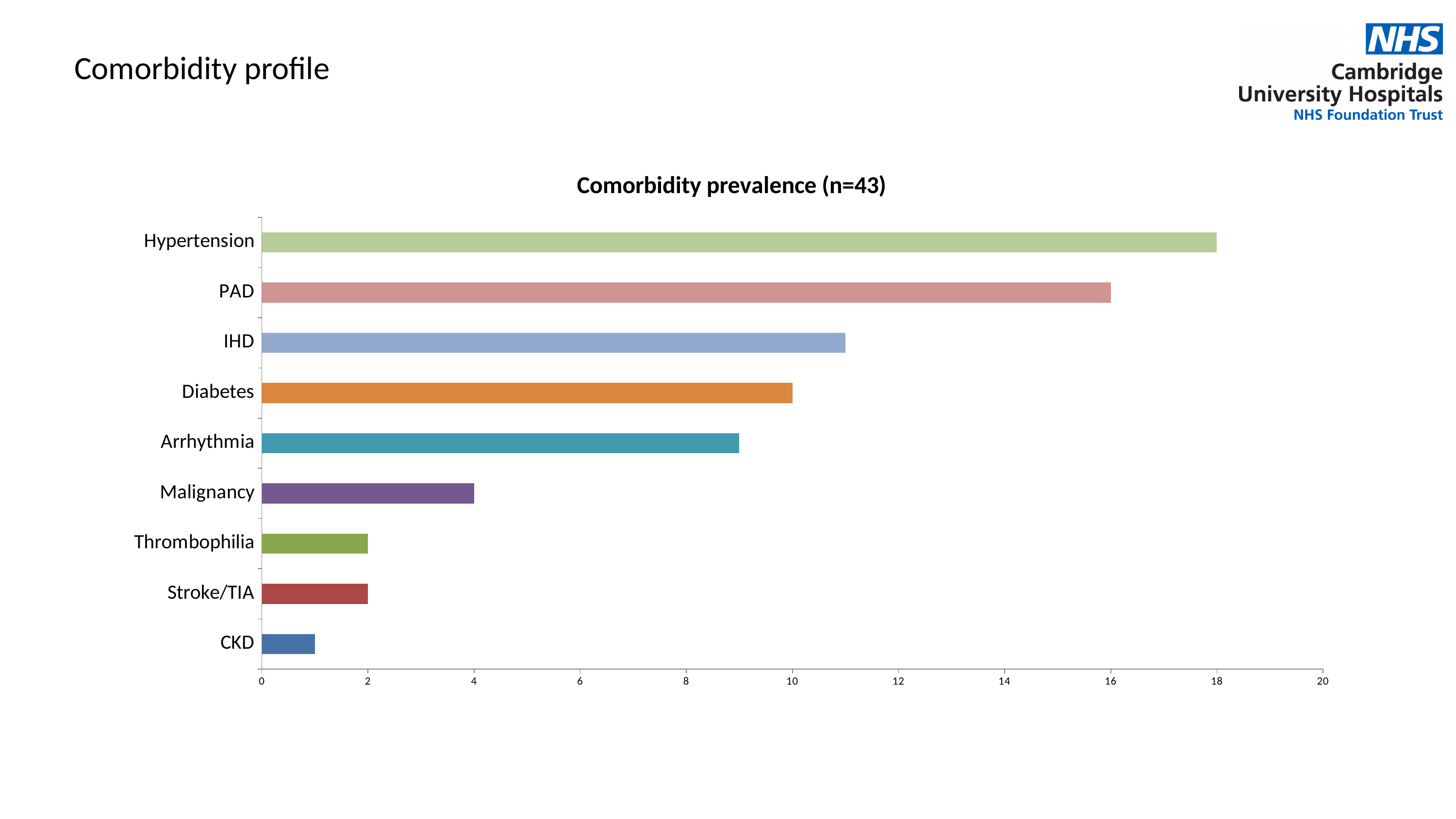
What is the difference between the values for Hypertension and PAD? 2 What is the title of the chart? Comorbidity prevalence (n=43) What is the value for Hypertension? 18 What is the value for Diabetes? 10 What type of chart is shown on the slide? bar chart How many comorbidity categories are plotted in the chart? 9 Is the value for IHD greater or less than 10? greater Which comorbidity has the lowest prevalence? CKD Which comorbidity has the highest prevalence? Hypertension Which is larger, the value for PAD or the value for IHD? PAD What is the value for PAD? 16 What is the value for Malignancy? 4